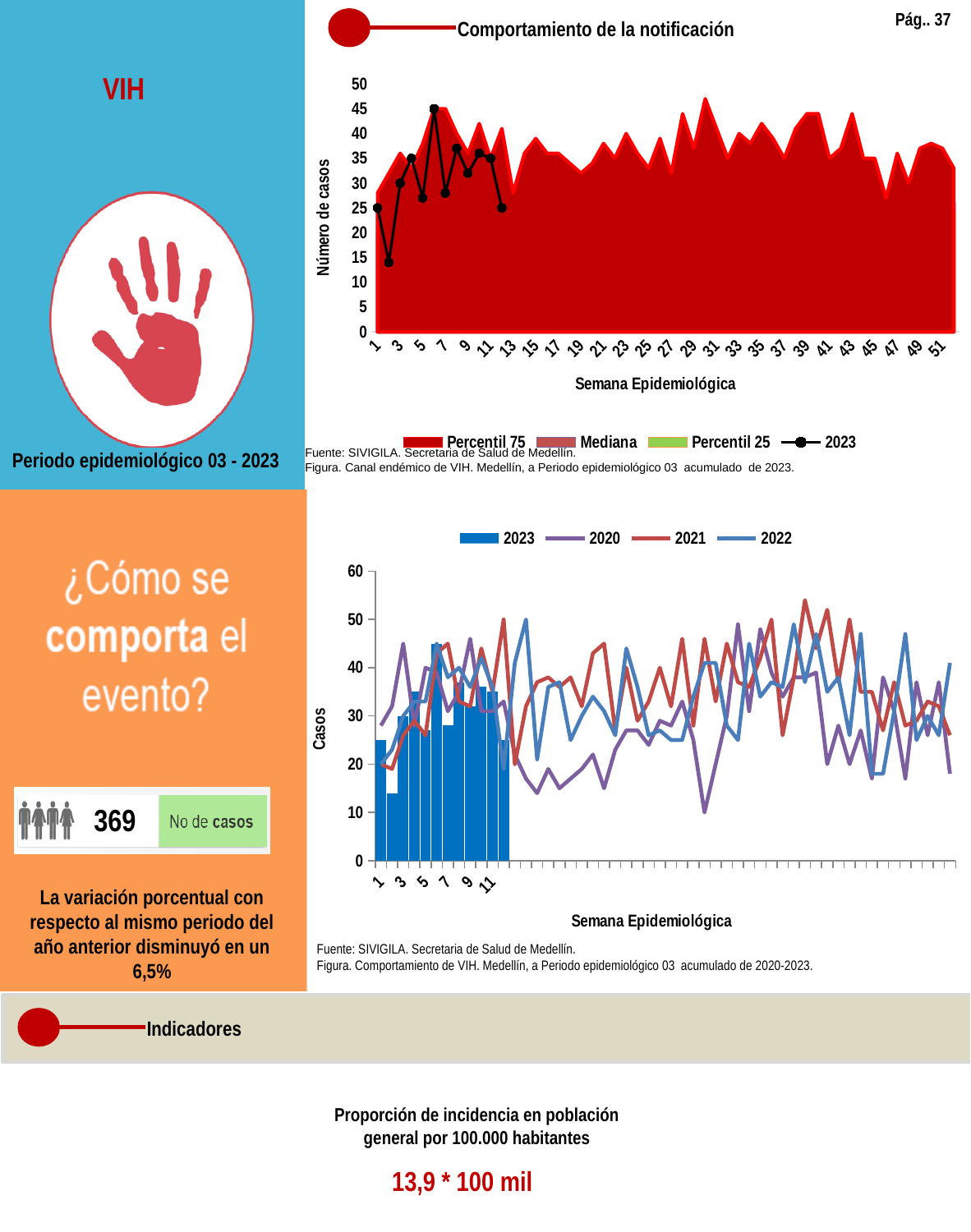
In the bottom chart (Comportamiento de VIH 2020-2023), how many series does the legend list? 4 In the top chart, which is larger for 2023: the value at week 1 or the value at week 2? Week 1 In the top chart, is the 2023 value at week 2 greater or less than 20? less In the top chart, at which epidemiological week does the 2023 line reach its highest value? Week 6 In the top chart, is the 2023 value at week 6 greater or less than 40? greater What is the y-axis label of the top chart? Número de casos In the bottom chart, is the 2023 bar at week 6 greater or less than 40? greater In the bottom chart, how many 2023 bars are plotted? 12 In the bottom chart, which year is shown as bars rather than a line? 2023 In the top chart (Canal endémico de VIH), how many series does the legend list? 4 In the top chart, at which epidemiological week does the 2023 line reach its lowest value? Week 2